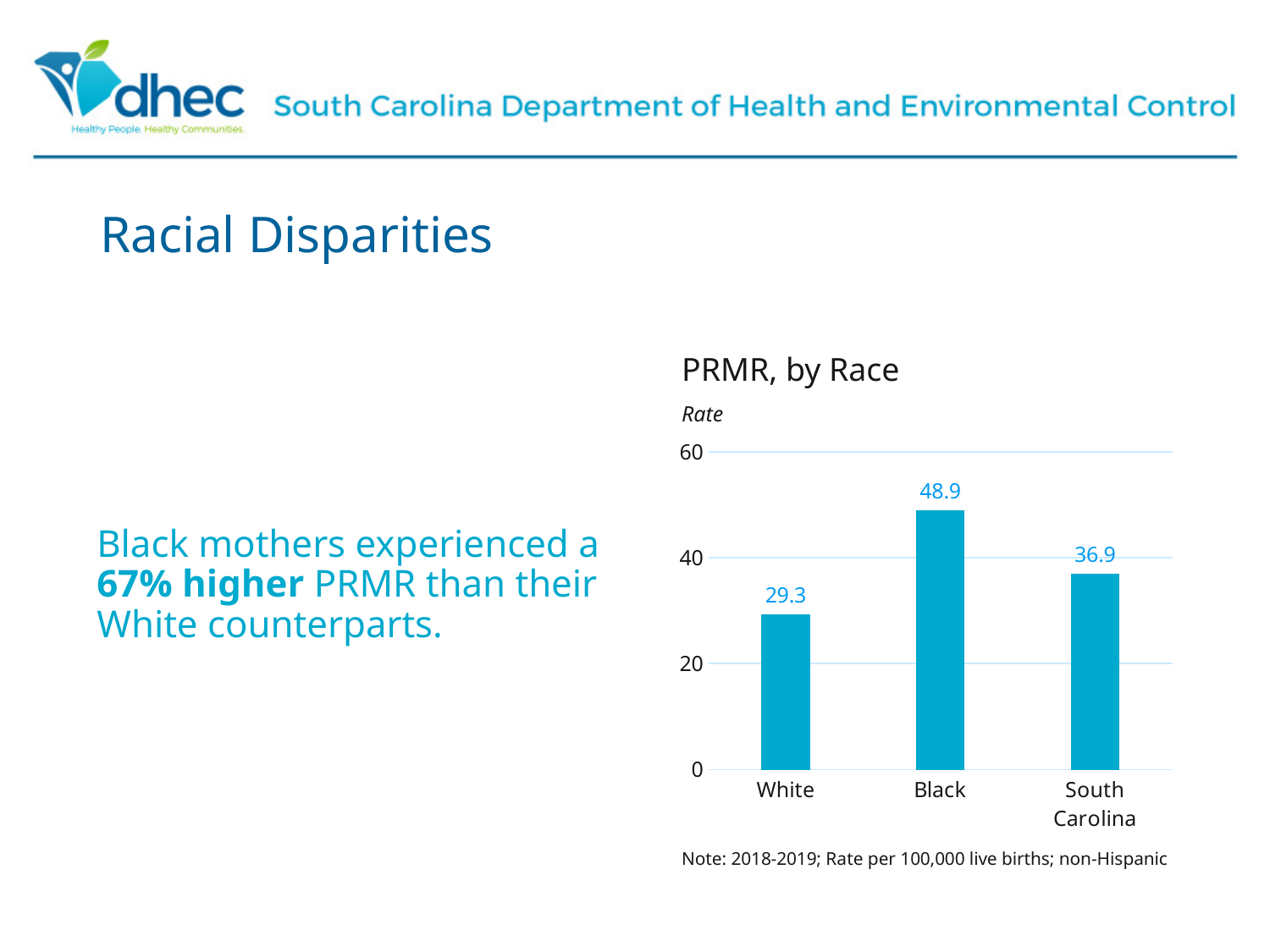
How many categories are shown on the x axis? 3 Which is larger, the PRMR for Black mothers or for South Carolina? Black What is the difference between the PRMR for Black mothers and White mothers? 19.6 What is the title of the chart? PRMR, by Race Which category has the highest PRMR? Black What is the difference between the PRMR for South Carolina and White mothers? 7.6 Is the PRMR for White mothers greater or less than 40? less What is the PRMR for South Carolina overall? 36.9 What kind of chart is shown on the slide? bar chart What is the PRMR for White mothers? 29.3 What is the PRMR for Black mothers? 48.9 Which category has the lowest PRMR? White